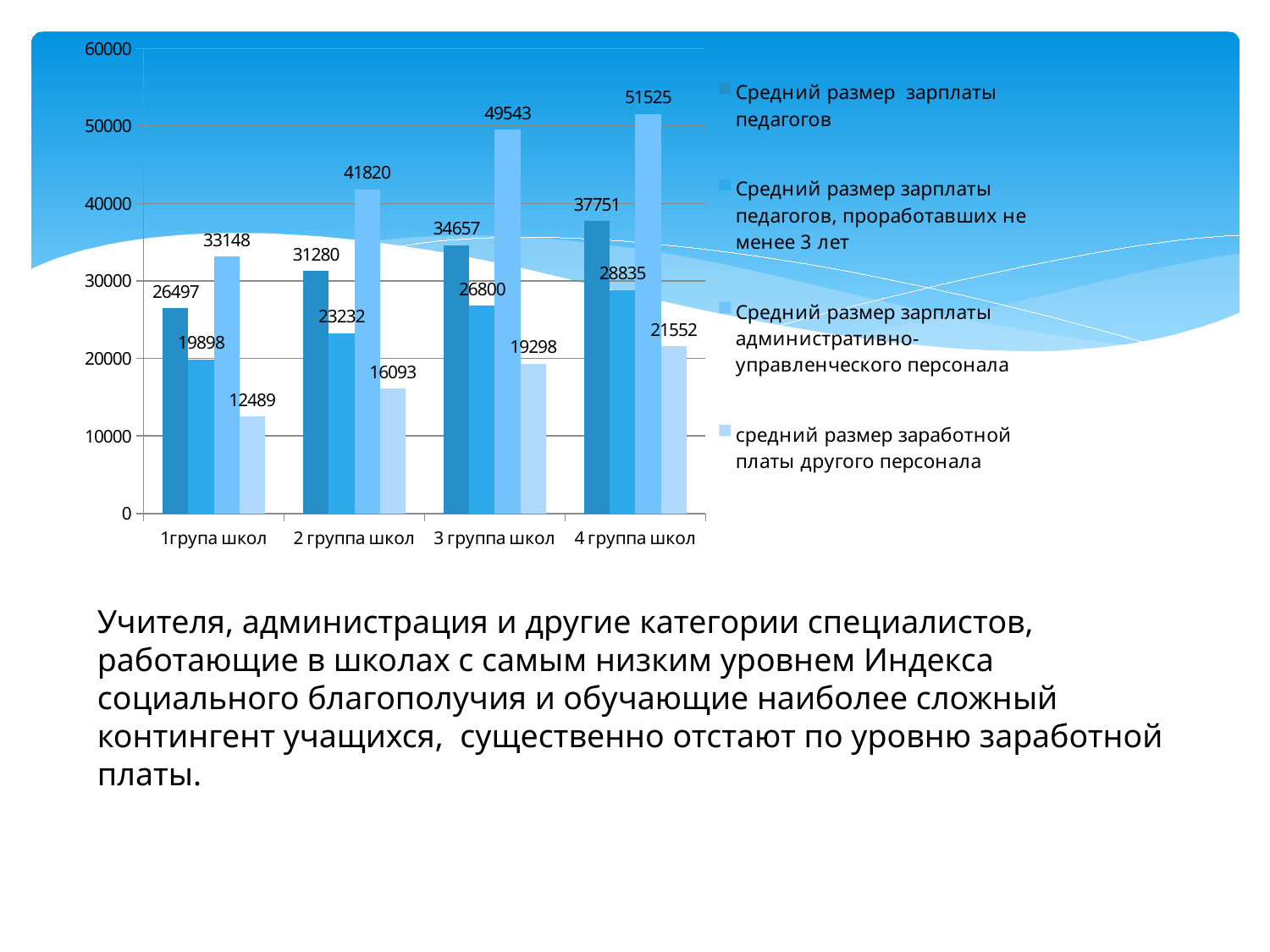
Which school group has the highest average salary of administrative and management staff? 4 группа школ How many school groups are shown on the x axis? 4 Do the average teacher salaries (Средний размер зарплаты педагогов) rise or fall from 1группа школ to 4 группа школ? Rise What is the average salary of teachers who have worked no more than 3 years (проработавших не менее 3 лет) for 3 группа школ? 26800 Which school group has the lowest average salary of other staff (другого персонала)? 1группа школ Which is larger: the average teacher salary for 2 группа школ or the average salary of administrative and management staff for 2 группа школ? Administrative and management staff (41820) What kind of chart is shown on the slide? Bar chart What is the difference between the average teacher salary for 4 группа школ and for 1группа школ? 11254 How many series does the legend list? 4 What is the average teacher salary (Средний размер зарплаты педагогов) for 1группа школ? 26497 What is the average salary of other staff (другого персонала) for 2 группа школ? 16093 What is the average salary of administrative and management staff (административно-управленческого персонала) for 4 группа школ? 51525